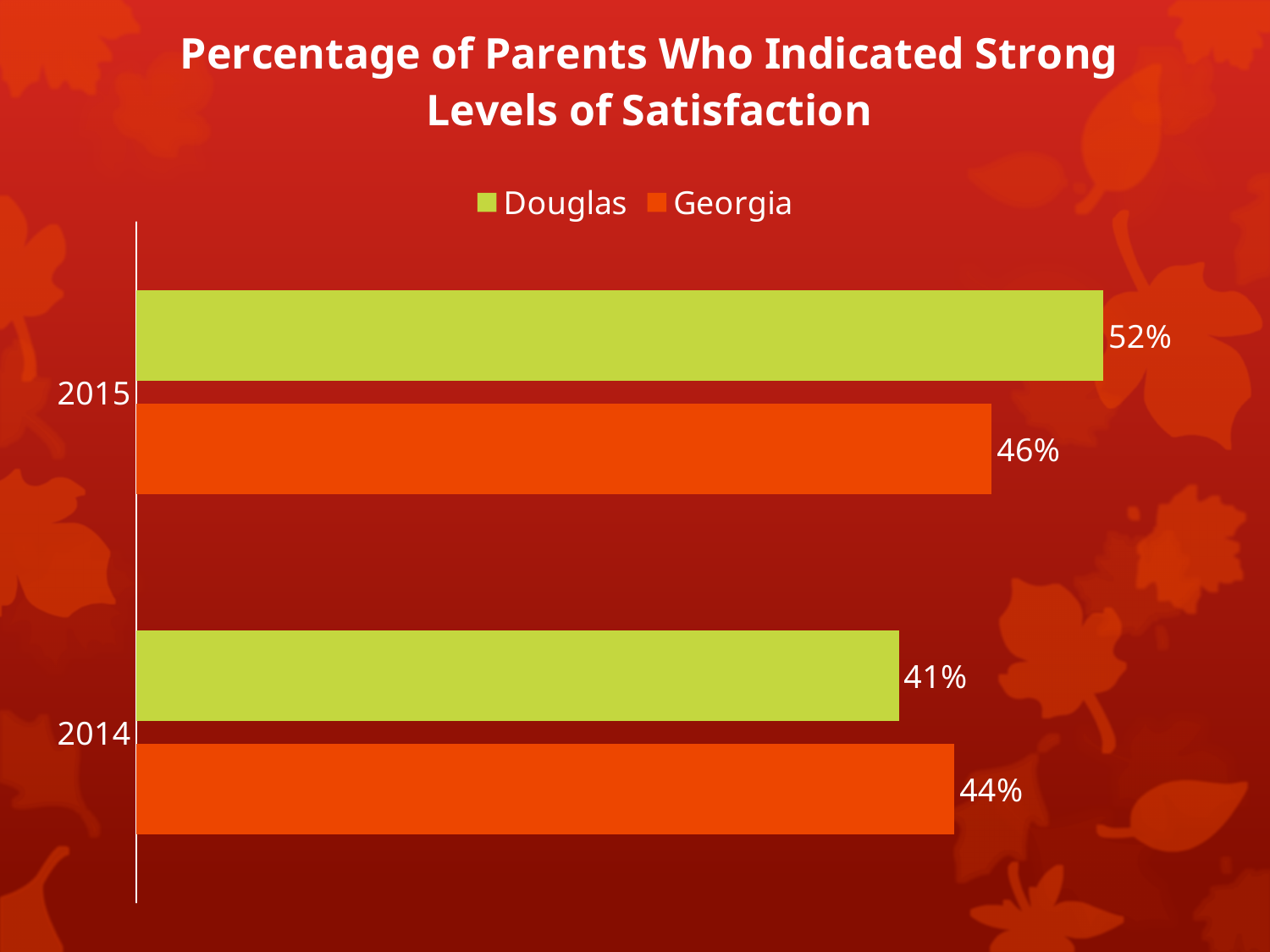
Which series has the lowest value in 2014? Douglas What is the difference between Douglas and Georgia in 2015? 6% What is the value for Douglas in 2015? 52% What is the difference between Douglas in 2015 and Douglas in 2014? 11% Which series has the highest value in 2015? Douglas How many series does the legend list? 2 What is the value for Georgia in 2015? 46% How many years are shown on the chart? 2 What is the value for Douglas in 2014? 41% What kind of chart is shown on the slide? Bar chart Which is larger in 2014, Douglas or Georgia? Georgia What is the value for Georgia in 2014? 44%